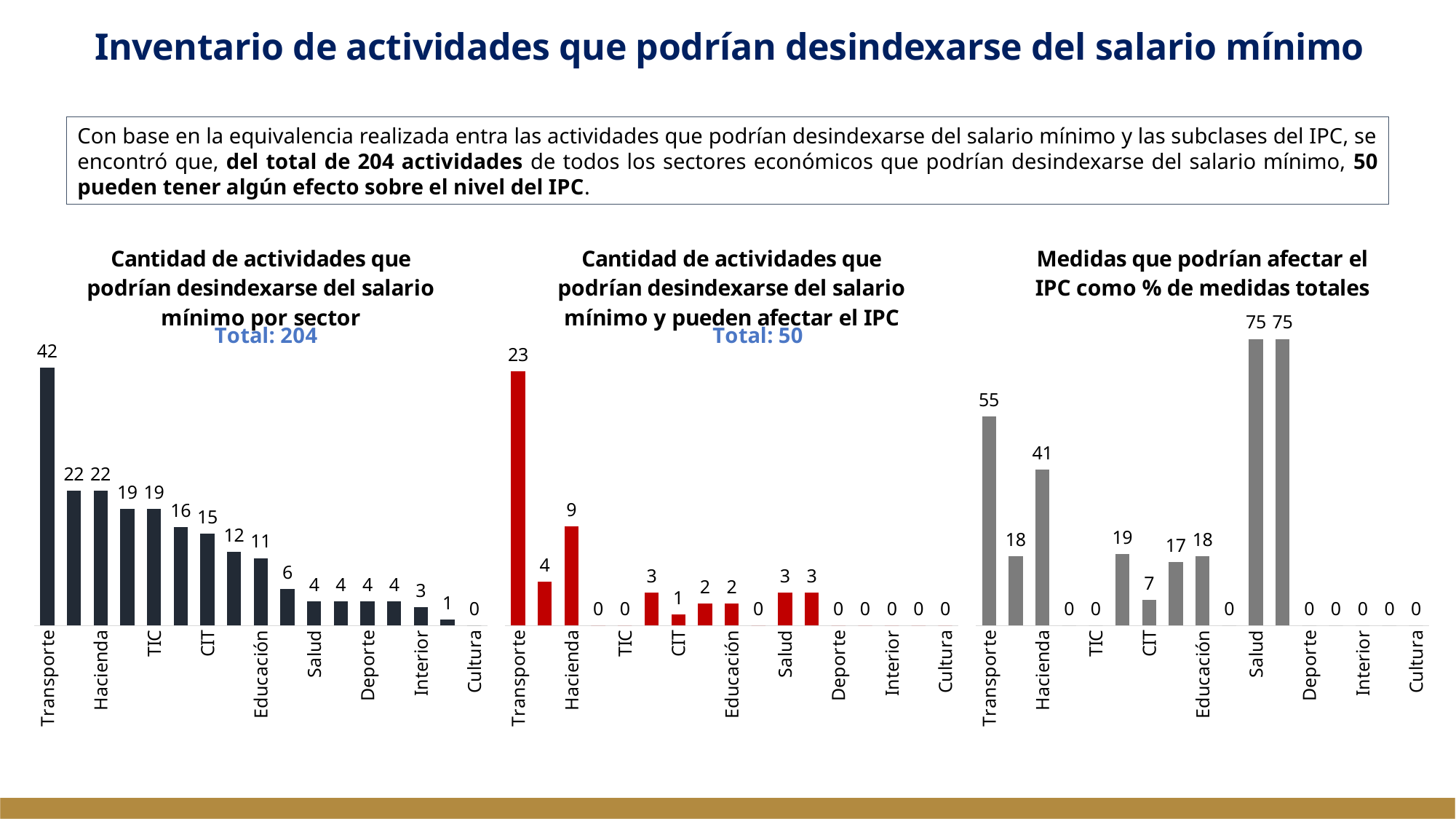
In the left chart 'Cantidad de actividades que podrían desindexarse del salario mínimo por sector', what is the difference between Transporte and Hacienda? 20 In the middle chart 'Cantidad de actividades que podrían desindexarse del salario mínimo y pueden afectar el IPC', what is the value for Hacienda? 9 In the middle chart 'Cantidad de actividades que podrían desindexarse del salario mínimo y pueden afectar el IPC', what is the value for Salud? 3 In the left chart 'Cantidad de actividades que podrían desindexarse del salario mínimo por sector', what is the value for Transporte? 42 In the left chart 'Cantidad de actividades que podrían desindexarse del salario mínimo por sector', what is the value for Cultura? 0 In the left chart 'Cantidad de actividades que podrían desindexarse del salario mínimo por sector', what total is shown below the title? Total: 204 In the right chart 'Medidas que podrían afectar el IPC como % de medidas totales', what is the value for Transporte? 55 In the middle chart 'Cantidad de actividades que podrían desindexarse del salario mínimo y pueden afectar el IPC', which is larger, Transporte or Hacienda? Transporte In the right chart 'Medidas que podrían afectar el IPC como % de medidas totales', what is the difference between Transporte and Hacienda? 14 What kind of chart is the right chart 'Medidas que podrían afectar el IPC como % de medidas totales'? Bar chart In the right chart 'Medidas que podrían afectar el IPC como % de medidas totales', what is the value for Salud? 75 In the left chart 'Cantidad de actividades que podrían desindexarse del salario mínimo por sector', which sector has the highest value? Transporte